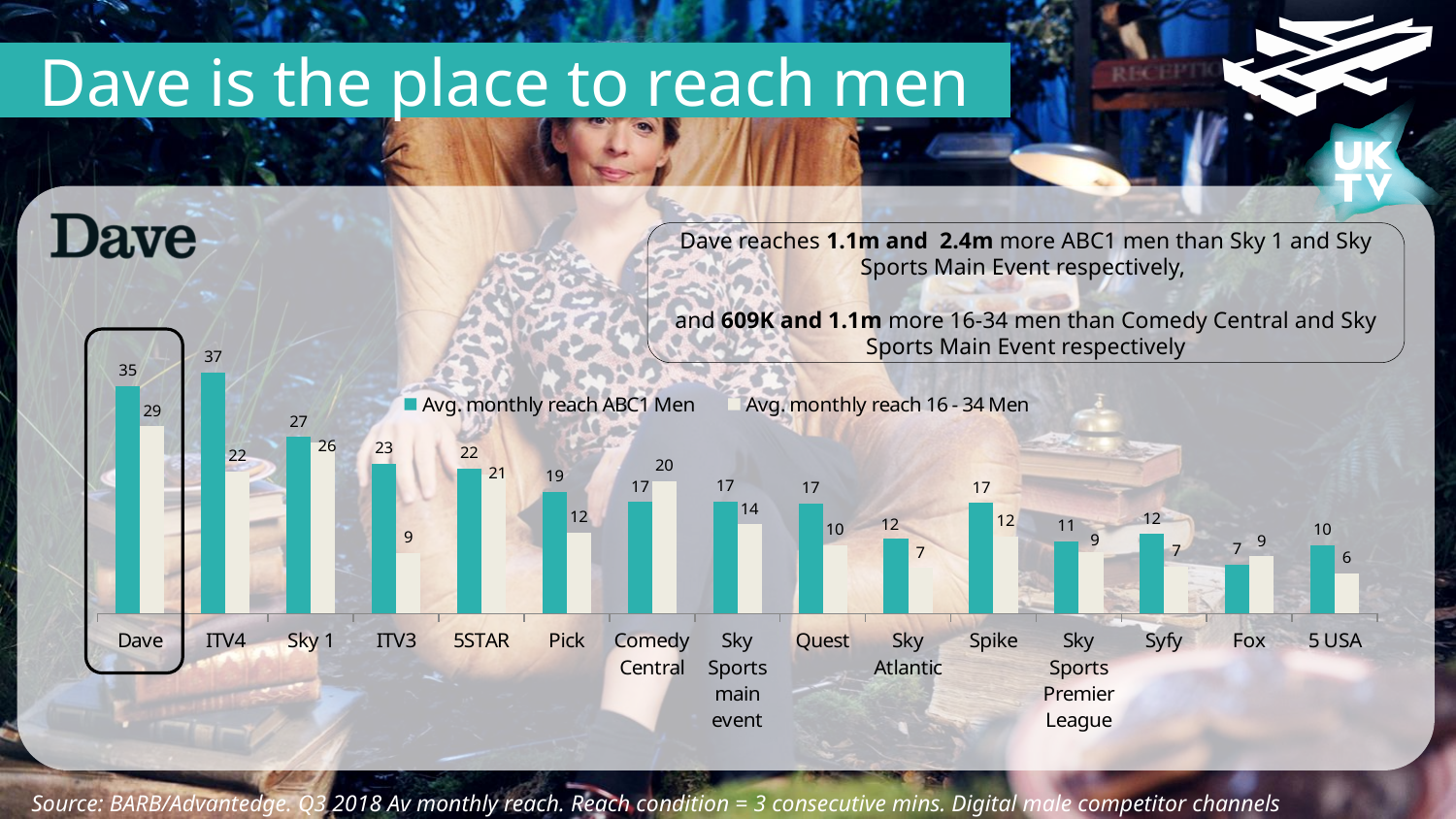
What is the Avg. monthly reach 16 - 34 Men value for Comedy Central? 20 What is the Avg. monthly reach 16 - 34 Men value for Sky 1? 26 How many channels are shown on the x axis of the chart? 15 What type of chart is shown on the slide? Bar chart What is the difference between the Avg. monthly reach ABC1 Men and Avg. monthly reach 16 - 34 Men values for ITV3? 14 Which channel has the highest Avg. monthly reach ABC1 Men? ITV4 How many series does the chart legend list? 2 Which channel has the lowest Avg. monthly reach 16 - 34 Men? 5 USA Which channel has the highest Avg. monthly reach 16 - 34 Men? Dave What is the difference between the Avg. monthly reach ABC1 Men values for ITV4 and Dave? 2 What is the Avg. monthly reach ABC1 Men value for Dave? 35 Which is larger for Fox: the Avg. monthly reach ABC1 Men value or the Avg. monthly reach 16 - 34 Men value? Avg. monthly reach 16 - 34 Men